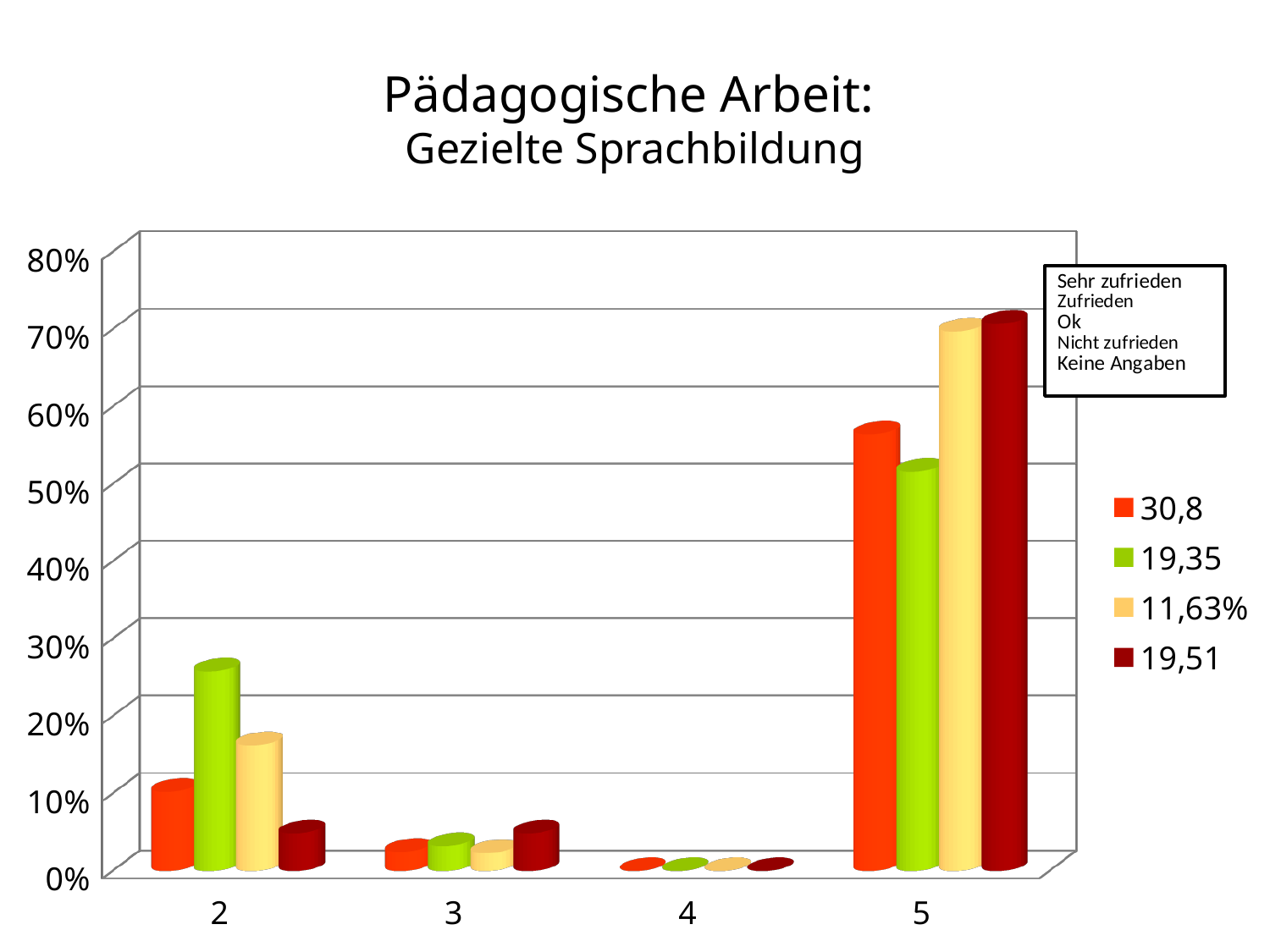
How many series does the legend list? 4 Is the value for the series "19,51" at category 2 greater or less than 10%? less At category 5, which series has the larger value: "11,63%" or "30,8"? 11,63% For the series "19,35", which category has the lowest value? 4 Is the value for the series "30,8" at category 5 greater or less than 50%? greater For the series "30,8", which category has the highest value? 5 Is the value for the series "19,35" at category 2 greater or less than 20%? greater At category 2, which series has the larger value: "19,35" or "30,8"? 19,35 What is the title of the chart? Pädagogische Arbeit: Gezielte Sprachbildung What kind of chart is shown on the slide? bar chart How many categories are shown on the x axis? 4